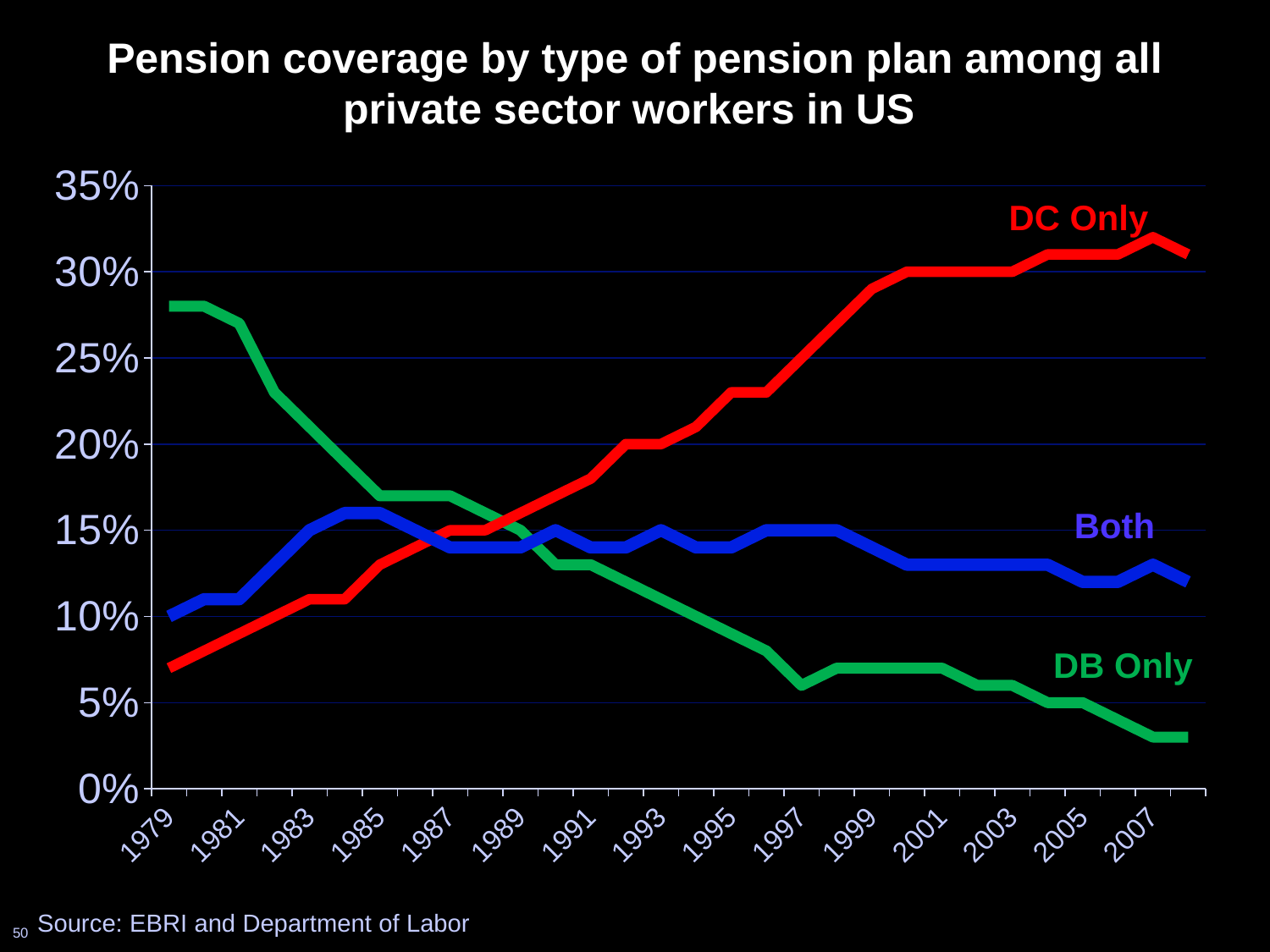
What kind of chart is shown on the slide? line chart Does the DC Only line rise or fall from 1979 to 2007? rise How many series are plotted on the chart? 3 Is the value for DC Only in 1979 greater or less than 10%? less Which series has the highest value in 1979? DB Only Which series has the highest value in 2007? DC Only Which series has the lowest value in 2007? DB Only Does the DB Only line rise or fall from 1979 to 2007? fall Is the value for DC Only in 2007 greater or less than 30%? greater What colour is the DB Only line? green Is the value for DB Only in 1979 greater or less than 25%? greater